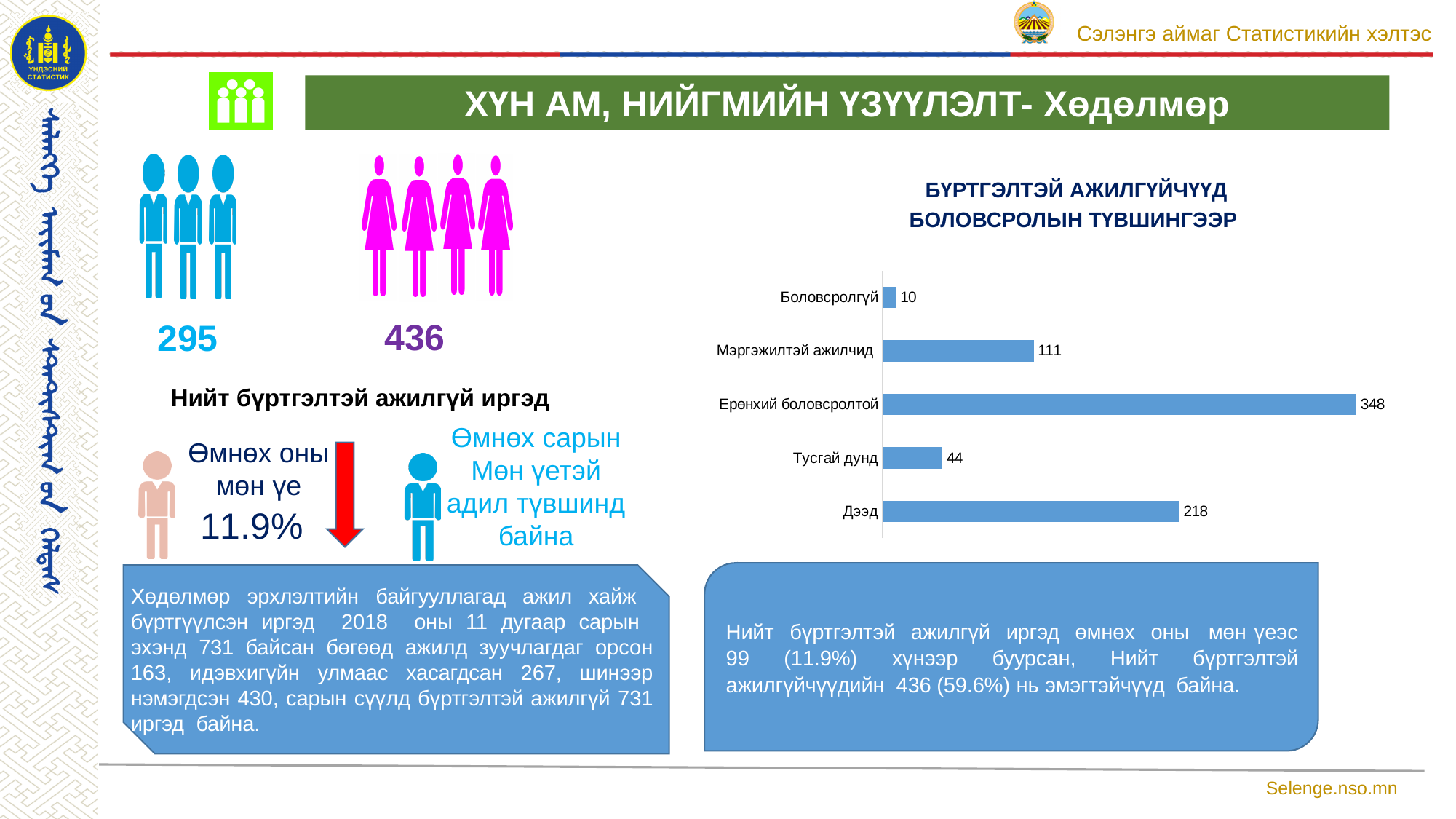
Which is larger, the value for Дээд or the value for Мэргэжилтэй ажилчид? Дээд What is the value for Боловсролгүй in the chart? 10 What is the value for Ерөнхий боловсролтой in the chart? 348 What is the difference between the values for Ерөнхий боловсролтой and Дээд? 130 What is the difference between the values for Мэргэжилтэй ажилчид and Тусгай дунд? 67 How many categories are shown in the chart? 5 What is the value for Тусгай дунд in the chart? 44 What is the value for Мэргэжилтэй ажилчид in the chart? 111 What kind of chart is shown on the slide? Bar chart Which category has the highest value in the chart? Ерөнхий боловсролтой Which category has the lowest value in the chart? Боловсролгүй What is the value for Дээд in the chart? 218